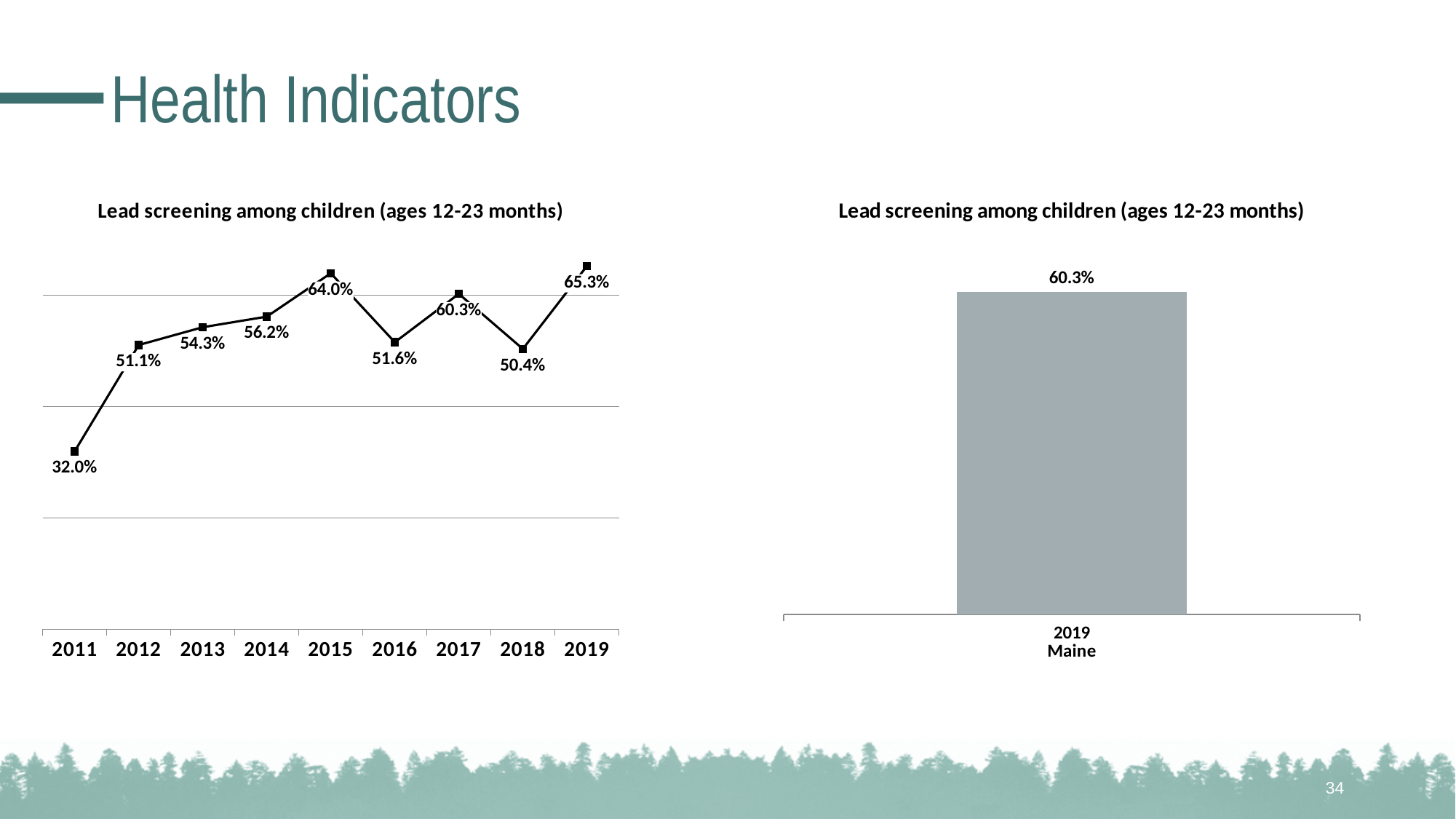
In the left chart, which year had the highest lead screening rate? 2019 What type of chart is the right chart? Bar chart In the left chart, what was the lead screening rate among children in 2011? 32.0% In the left chart, what is the difference between the 2019 and 2011 lead screening rates? 33.3 percentage points In the left chart, what was the lead screening rate in 2018? 50.4% In the left chart, what was the lead screening rate in 2015? 64.0% In the left chart, which year had a higher lead screening rate, 2016 or 2017? 2017 How many years are plotted in the left chart? 9 In the right chart, what is the lead screening rate for Maine in 2019? 60.3% In the left chart, which year had the lowest lead screening rate? 2011 In the left chart, did the lead screening rate rise or fall from 2015 to 2016? Fall What type of chart is the left chart? Line chart